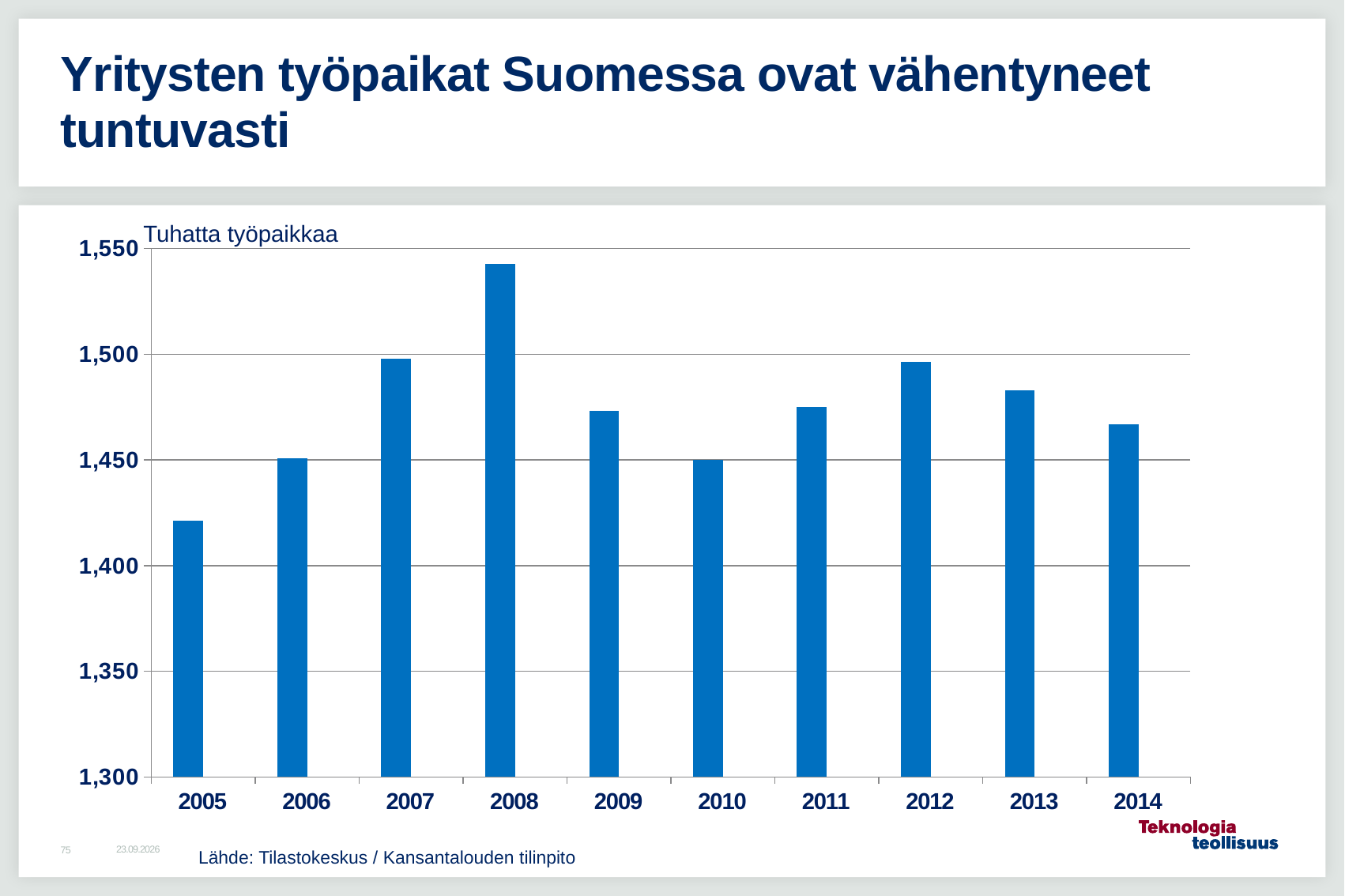
What kind of chart is shown on the slide? bar chart Do the values rise or fall from 2008 to 2010? fall Is the value for 2014 greater or less than 1,450? greater Which year has the highest number of jobs in the chart? 2008 Is the value for 2008 greater or less than 1,500? greater How many years are shown on the x axis of the chart? 10 Which year has a larger value, 2007 or 2009? 2007 Which year has a larger value, 2012 or 2014? 2012 What unit label is shown above the y axis of the chart? Tuhatta työpaikkaa Which year has the lowest number of jobs in the chart? 2005 Is the value for 2005 greater or less than 1,400? greater